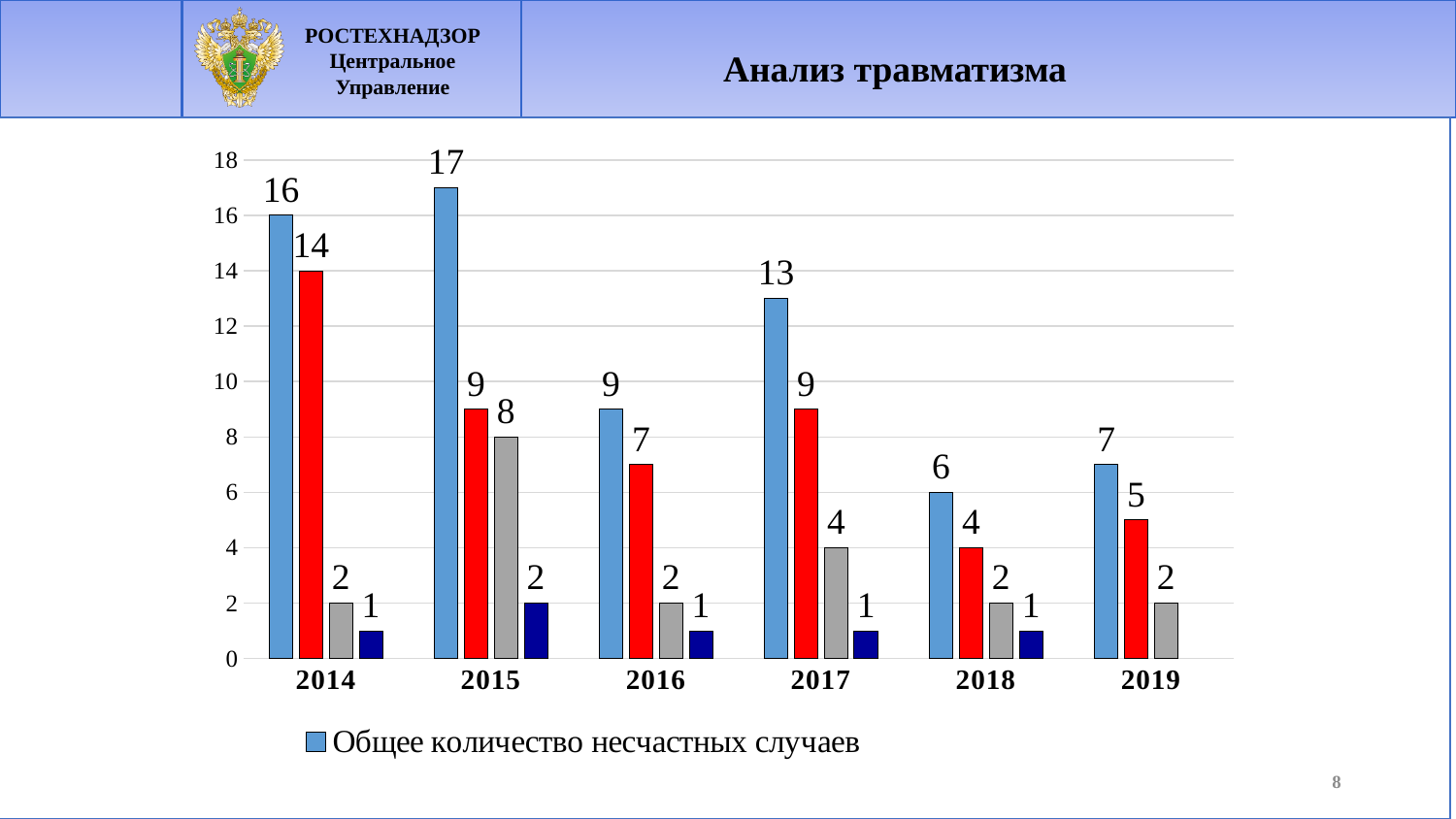
What is the value of the grey bar for 2015? 8 What is the title of the slide containing the chart? Анализ травматизма What is the value of "Общее количество несчастных случаев" for 2015? 17 How many series does the chart legend list? 1 In which year is "Общее количество несчастных случаев" highest? 2015 How many years are shown on the x axis of the chart? 6 What is the value of the red bar for 2014? 14 Which is larger: the red bar for 2016 or the red bar for 2017? 2017 What type of chart is shown on the slide? bar chart In which year is "Общее количество несчастных случаев" lowest? 2018 What is the value of "Общее количество несчастных случаев" for 2018? 6 What is the difference between "Общее количество несчастных случаев" in 2014 and in 2019? 9